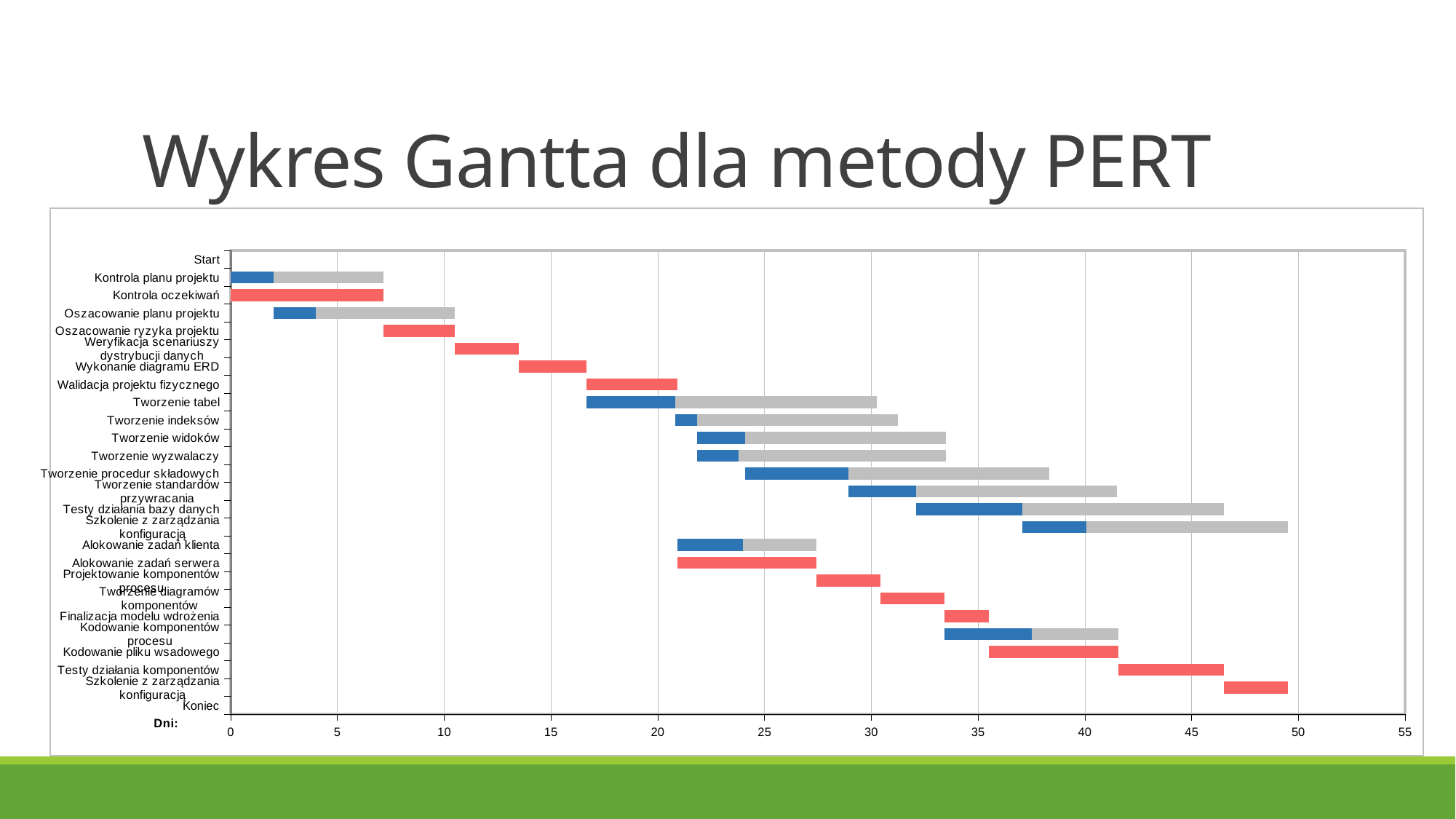
Does the red bar for "Kodowanie pliku wsadowego" end at a value greater or less than 40? greater What is the title of the slide containing the chart? Wykres Gantta dla metody PERT What label is shown next to the horizontal axis of the chart? Dni: Does the red bar for "Testy działania komponentów" end at a value greater or less than 45? greater What kind of chart is shown on the slide? Bar chart (Gantt chart) Does the red bar for "Alokowanie zadań serwera" end at a value greater or less than 30? less What is the highest value shown on the horizontal axis? 55 Which task's bar starts later: "Alokowanie zadań klienta" or "Tworzenie standardów przywracania"? Tworzenie standardów przywracania Which task's bar ends later: "Testy działania komponentów" or "Kodowanie pliku wsadowego"? Testy działania komponentów